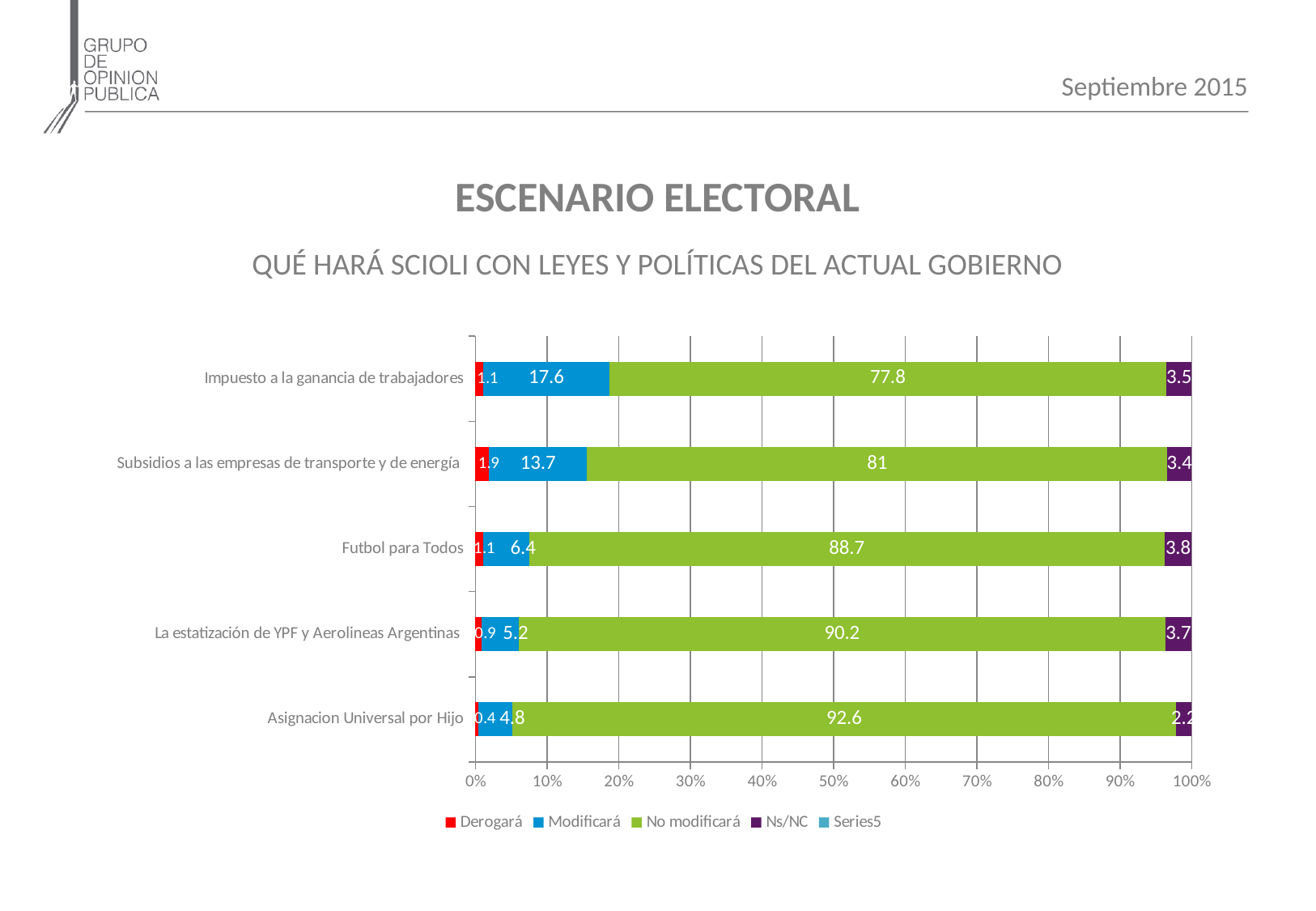
Which is larger: the "Modificará" value for Subsidios a las empresas de transporte y de energía or for Futbol para Todos? Subsidios a las empresas de transporte y de energía What is the value of "Derogará" for Subsidios a las empresas de transporte y de energía? 1.9 Which category has the highest "No modificará" value? Asignacion Universal por Hijo How many series does the legend list? 5 What colour represents "No modificará" in the chart? Green What is the value of "No modificará" for Futbol para Todos? 88.7 What is the value of "Modificará" for Impuesto a la ganancia de trabajadores? 17.6 Which category has the highest "Modificará" value? Impuesto a la ganancia de trabajadores How many categories are shown on the chart? 5 What is the difference between the "Modificará" values for Impuesto a la ganancia de trabajadores and Subsidios a las empresas de transporte y de energía? 3.9 What kind of chart is shown on the slide? Stacked bar chart Which category has the lowest "Derogará" value? Asignacion Universal por Hijo